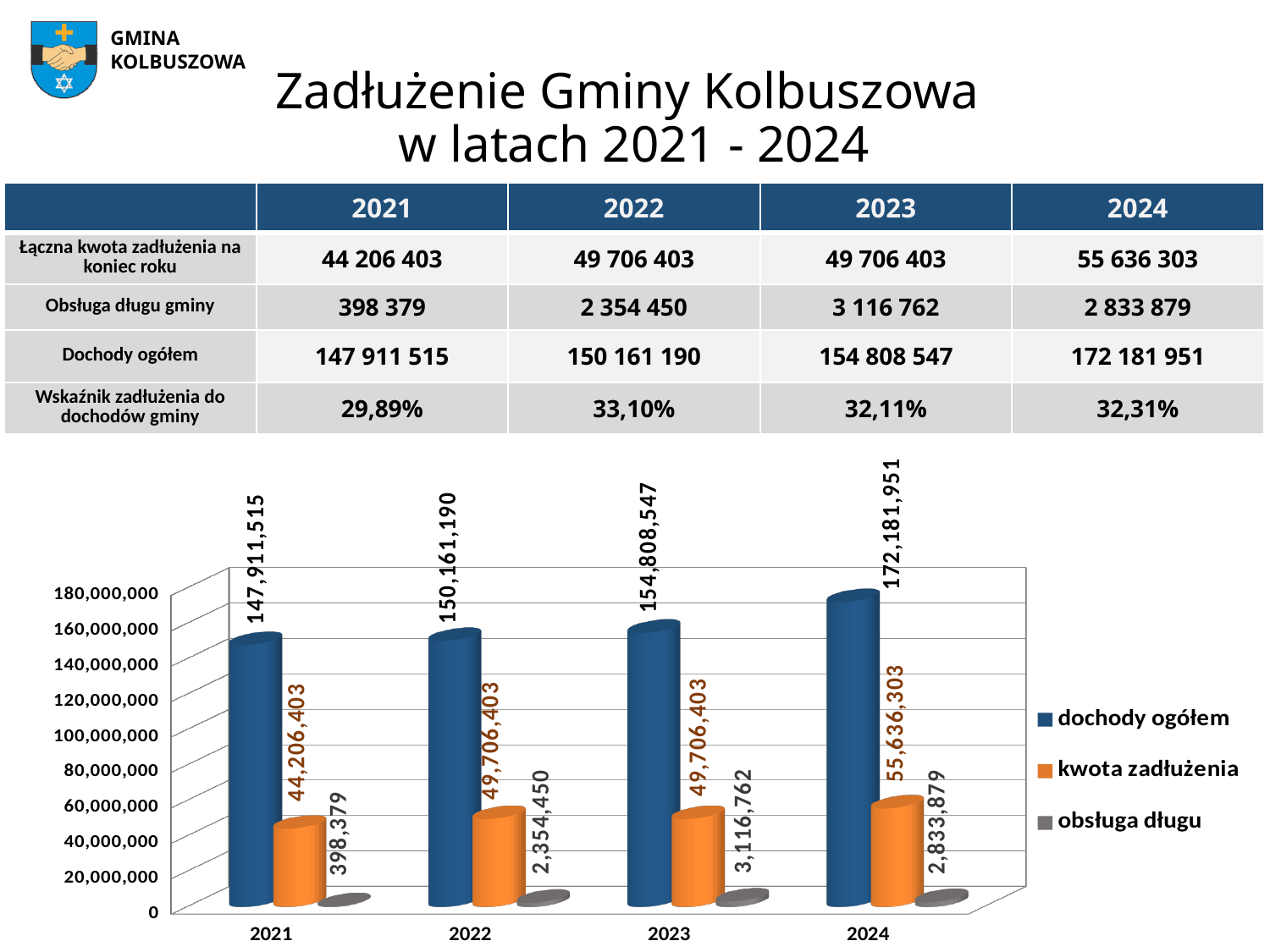
What type of chart is shown on the slide? bar chart Which year has the highest value for dochody ogółem? 2024 Is the value of dochody ogółem for 2023 greater or less than 160,000,000? less Does dochody ogółem rise or fall from 2021 to 2024? rise What is the value of obsługa długu for 2023 in the chart? 3,116,762 What is the difference between kwota zadłużenia in 2024 and in 2021? 11,429,900 What is the value of kwota zadłużenia for 2021 in the chart? 44,206,403 Is obsługa długu larger in 2022 or in 2023? 2023 What is the value of dochody ogółem for 2024 in the chart? 172,181,951 Which year has the lowest value for obsługa długu? 2021 How many years are shown on the x axis of the chart? 4 How many series does the chart legend list? 3